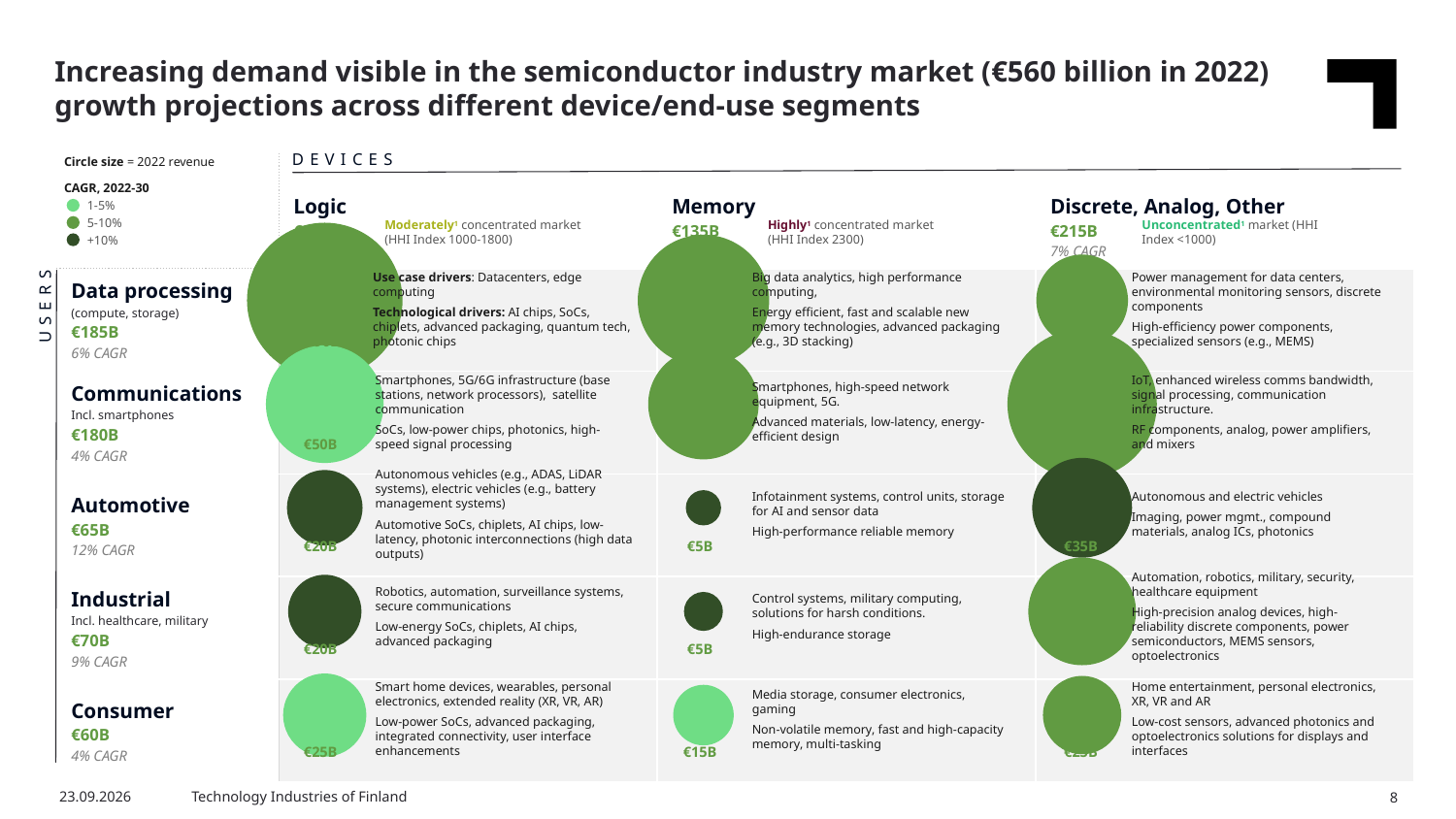
Which user segment has the lowest 2022 revenue shown on the slide? Consumer What is the difference between the Data processing revenue (€185B) and the Communications revenue (€180B)? €5B What is the 2022 revenue shown for the Memory device segment? €135B What is the 2022 revenue shown for the Discrete, Analog, Other device segment? €215B Which user segment has the highest CAGR shown on the slide? Automotive What value is labelled on the circle at the intersection of Logic and Communications? €50B What is the 2022 revenue shown for the Data processing user segment? €185B What value is labelled on the circle at the intersection of Memory and Consumer? €15B How many CAGR bands does the legend list? 3 What value is labelled on the circle at the intersection of Discrete, Analog, Other and Automotive? €35B What CAGR is shown for the Automotive user segment? 12% CAGR Which is larger: the Logic/Consumer circle value or the Memory/Consumer circle value? Logic/Consumer (€25B)